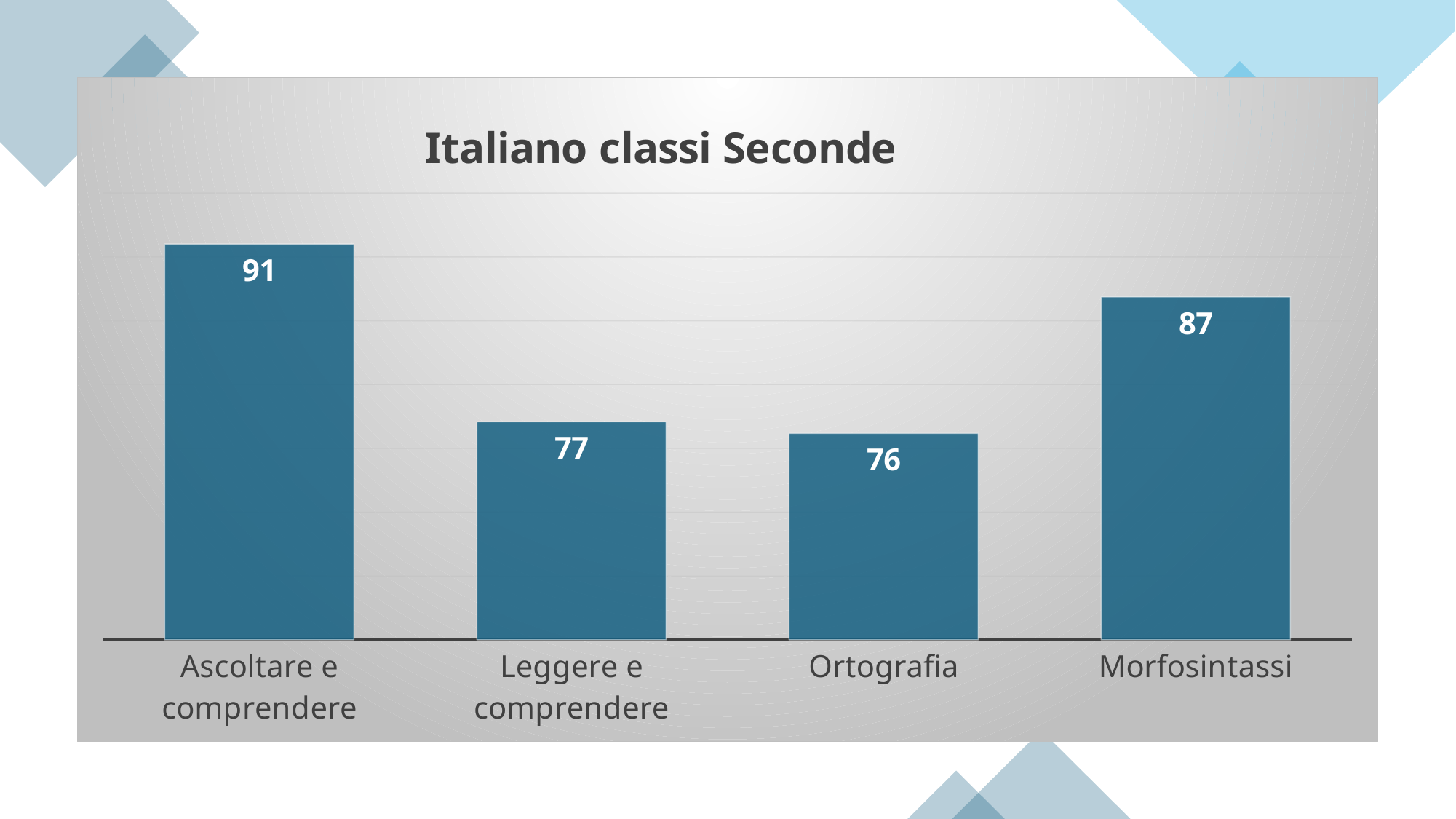
Which category has the highest value? Ascoltare e comprendere What is the difference between the values for Ascoltare e comprendere and Morfosintassi? 4 What is the value for Morfosintassi? 87 What is the value for Ortografia? 76 Which category has the lowest value? Ortografia What is the value for Ascoltare e comprendere? 91 What is the difference between the values for Leggere e comprendere and Ortografia? 1 How many categories are shown in the chart? 4 What kind of chart is shown on the slide? Bar chart Which is larger, the value for Morfosintassi or the value for Leggere e comprendere? Morfosintassi What is the title of the chart? Italiano classi Seconde What is the value for Leggere e comprendere? 77